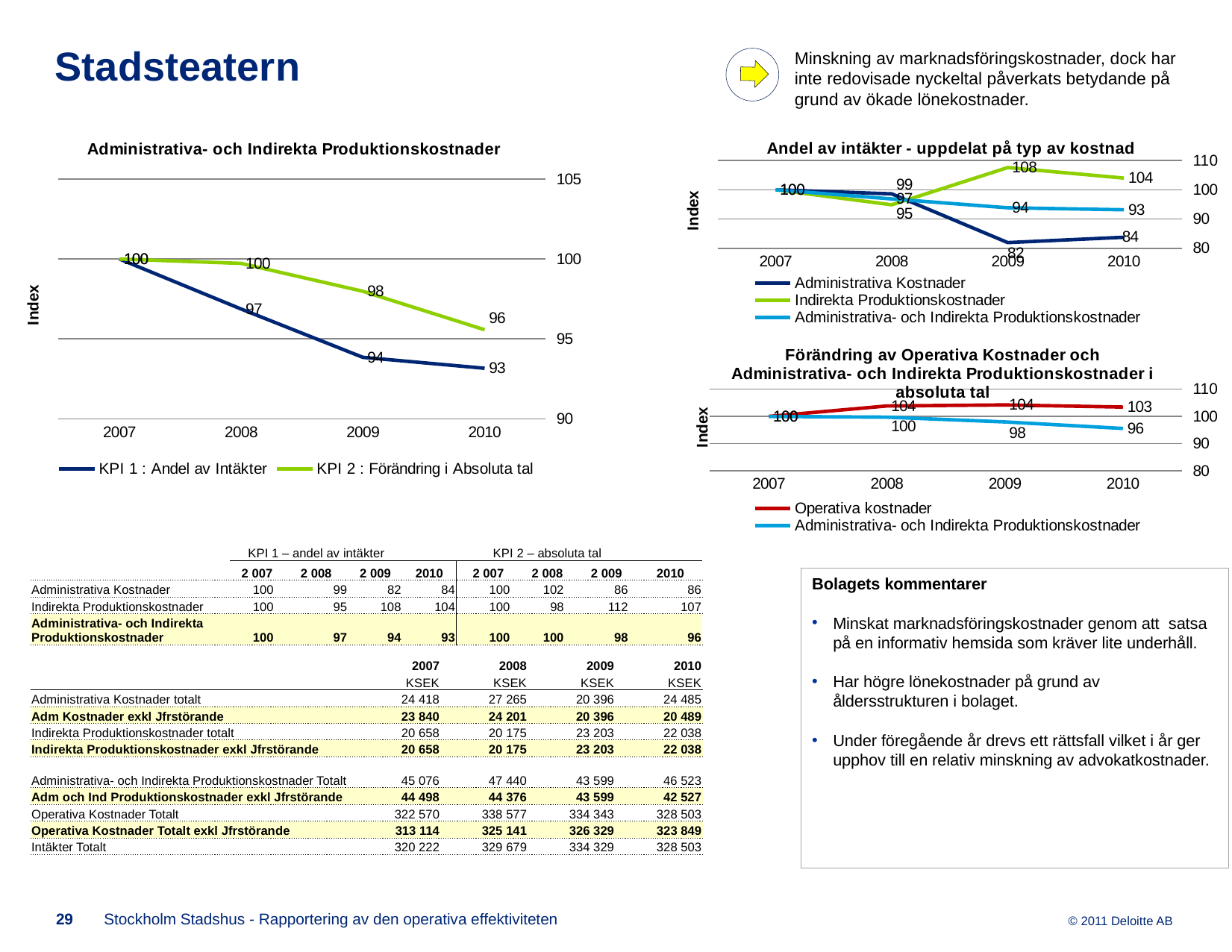
In the chart titled "Andel av intäkter - uppdelat på typ av kostnad", what is the difference between Indirekta Produktionskostnader and Administrativa Kostnader in 2010? 20 What type of chart is "Andel av intäkter - uppdelat på typ av kostnad"? line chart In the chart titled "Administrativa- och Indirekta Produktionskostnader", what is the difference between KPI 2 and KPI 1 in 2010? 3 In the chart titled "Andel av intäkter - uppdelat på typ av kostnad", which series has the highest value in 2009? Indirekta Produktionskostnader In the chart titled "Administrativa- och Indirekta Produktionskostnader", how many series does the legend list? 2 In the chart titled "Administrativa- och Indirekta Produktionskostnader", what is the value of KPI 1 : Andel av Intäkter in 2009? 94 In the chart titled "Administrativa- och Indirekta Produktionskostnader", what is the value of KPI 2 : Förändring i Absoluta tal in 2010? 96 In the chart titled "Andel av intäkter - uppdelat på typ av kostnad", what is the value of Administrativa Kostnader in 2009? 82 In the chart titled "Andel av intäkter - uppdelat på typ av kostnad", how many series does the legend list? 3 In the chart titled "Administrativa- och Indirekta Produktionskostnader", does KPI 1 : Andel av Intäkter rise or fall from 2007 to 2010? fall In the bottom-right chart ("Förändring av Operativa Kostnader..."), what is the value of Operativa kostnader in 2008? 104 In the bottom-right chart ("Förändring av Operativa Kostnader..."), which series has the larger value in 2010, Operativa kostnader or Administrativa- och Indirekta Produktionskostnader? Operativa kostnader